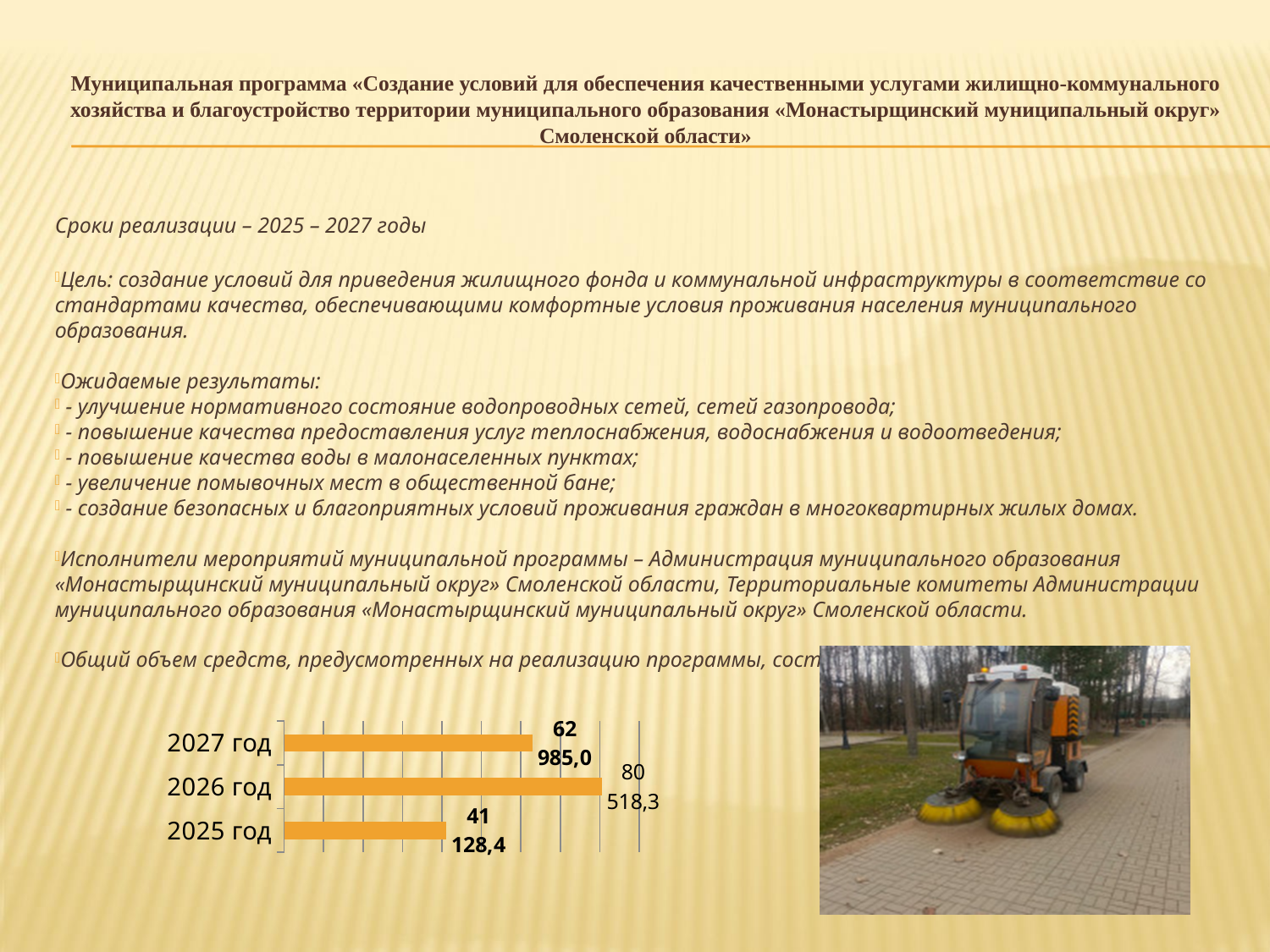
What is the value shown for 2025 год? 41 128,4 What is the value shown for 2027 год? 62 985,0 What colour are the bars in the chart? orange What is the difference between the values for 2026 год and 2027 год? 17 533,3 Which year has the lowest value in the chart? 2025 год What is the value shown for 2026 год? 80 518,3 Which year has the highest value in the chart? 2026 год Which is larger, the value for 2027 год or the value for 2025 год? 2027 год How many categories (years) does the chart show? 3 What is the difference between the values for 2026 год and 2025 год? 39 389,9 Do the values rise or fall from 2026 год to 2027 год? fall What type of chart is shown on the slide? bar chart